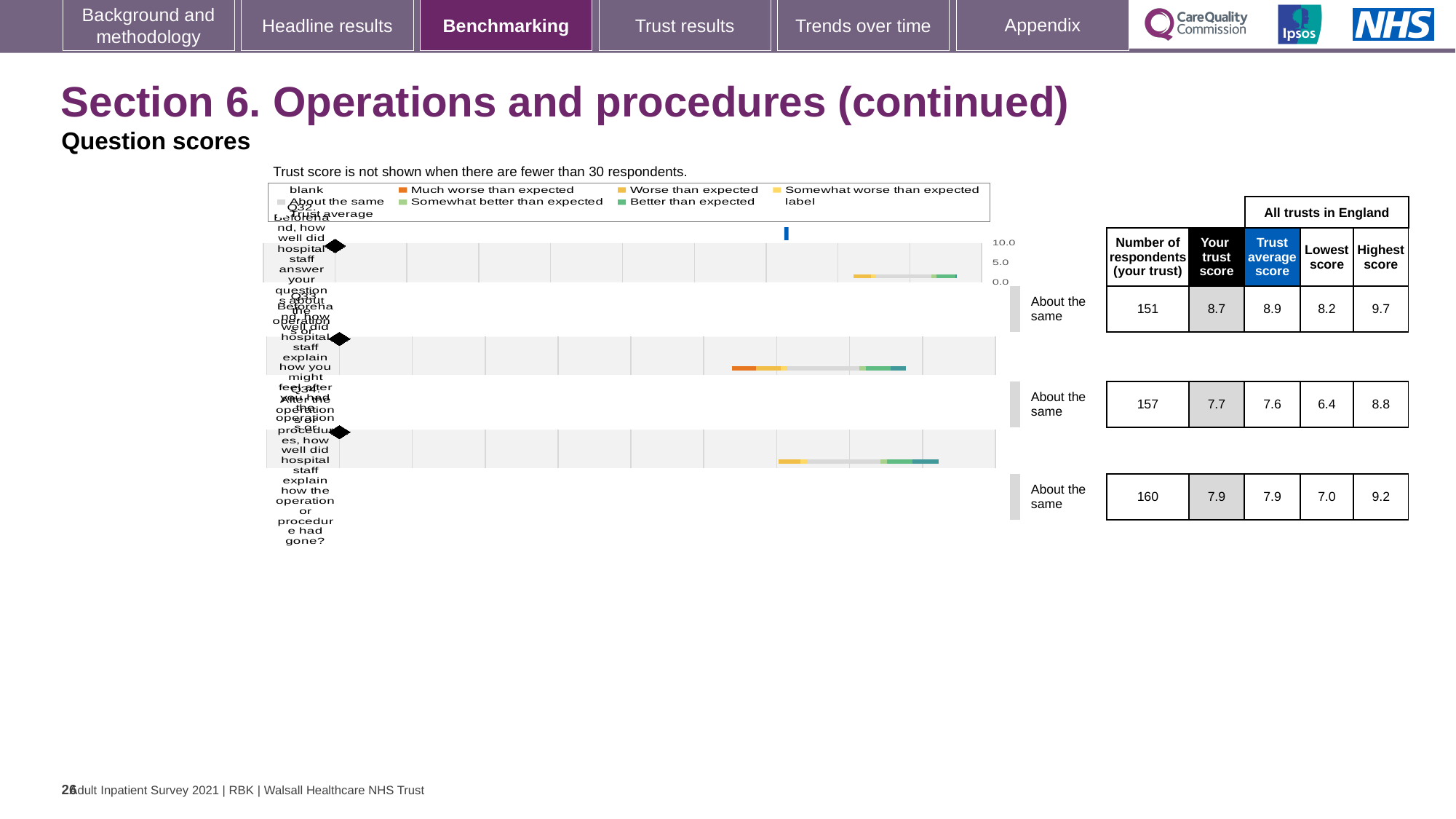
What kind of chart is used to show the question scores? Bar chart Which question row has the highest 'Your trust score'? The first row What benchmark category label is shown next to each of the three question rows? About the same How many respondents are shown for the first question row in the chart? 151 What is the lowest score across all trusts in England for the second question row? 6.4 What is the highest score across all trusts in England for the third question row? 9.2 For the first question row, which is larger: the trust's own score or the trust average score? Trust average score Which question row has the fewest respondents? The first row What is the 'Your trust score' value for the first question row? 8.7 What is the trust average score for the second question row? 7.6 For the first question row, what is the difference between the highest score and the lowest score across all trusts in England? 1.5 How many question rows are plotted in the chart? 3